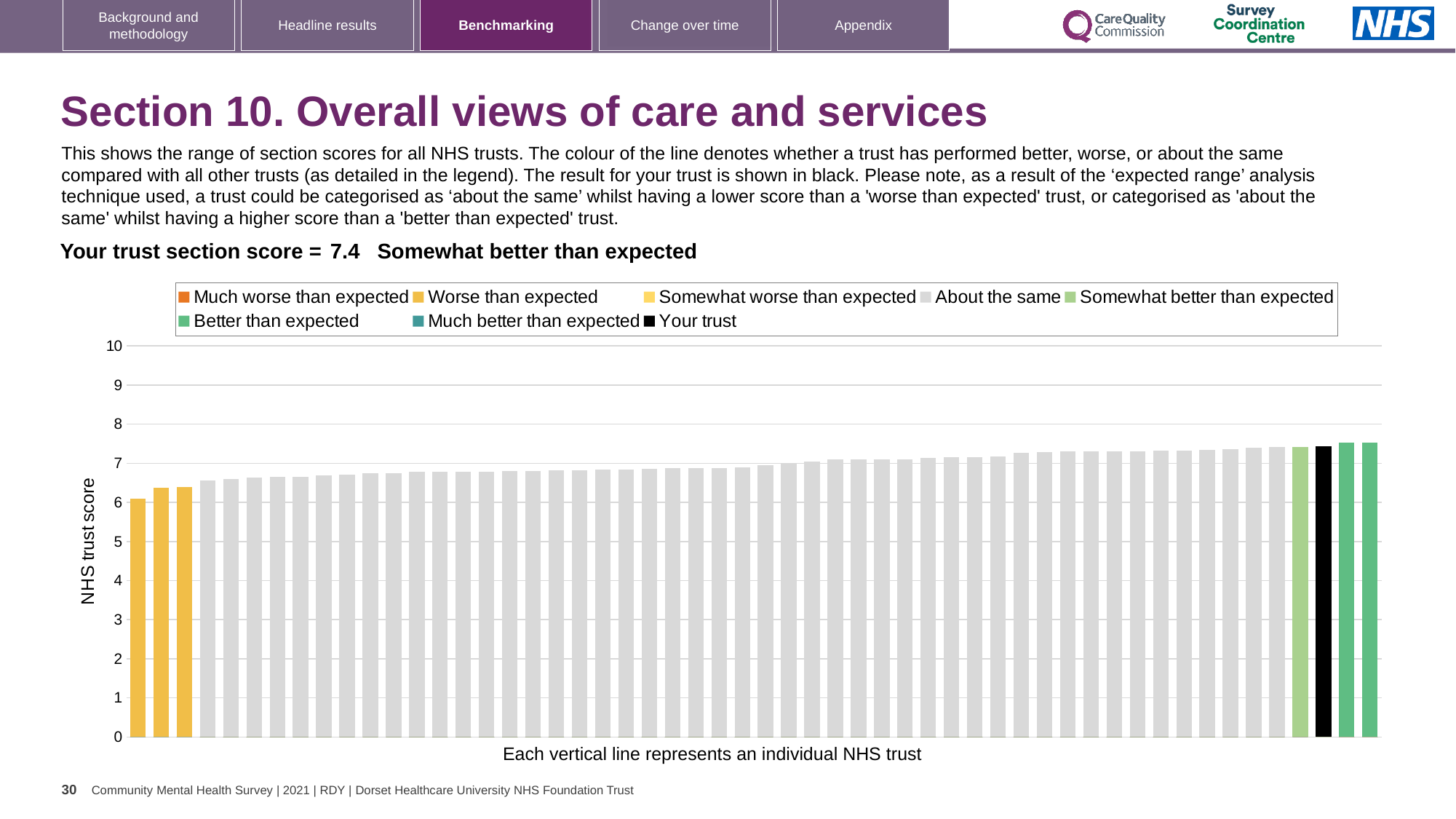
How many entries does the chart legend list? 8 What kind of chart is shown on the slide? bar chart Is the value of the lowest bar in the chart greater or less than 7? less What is the label on the vertical axis of the chart? NHS trust score Which is higher, the black bar for your trust or the leftmost yellow bar? the black bar for your trust How is your trust's section score of 7.4 categorised on the slide? Somewhat better than expected How many bars are coloured as 'Better than expected' (green)? 2 Is the value for your trust (the black bar) greater or less than 7? greater Do the bar values rise or fall from left to right across the chart? rise How many bars are coloured as 'Worse than expected' (yellow)? 3 Is the value of the highest bar in the chart greater or less than 8? less What is the section score for your trust shown on the slide? 7.4